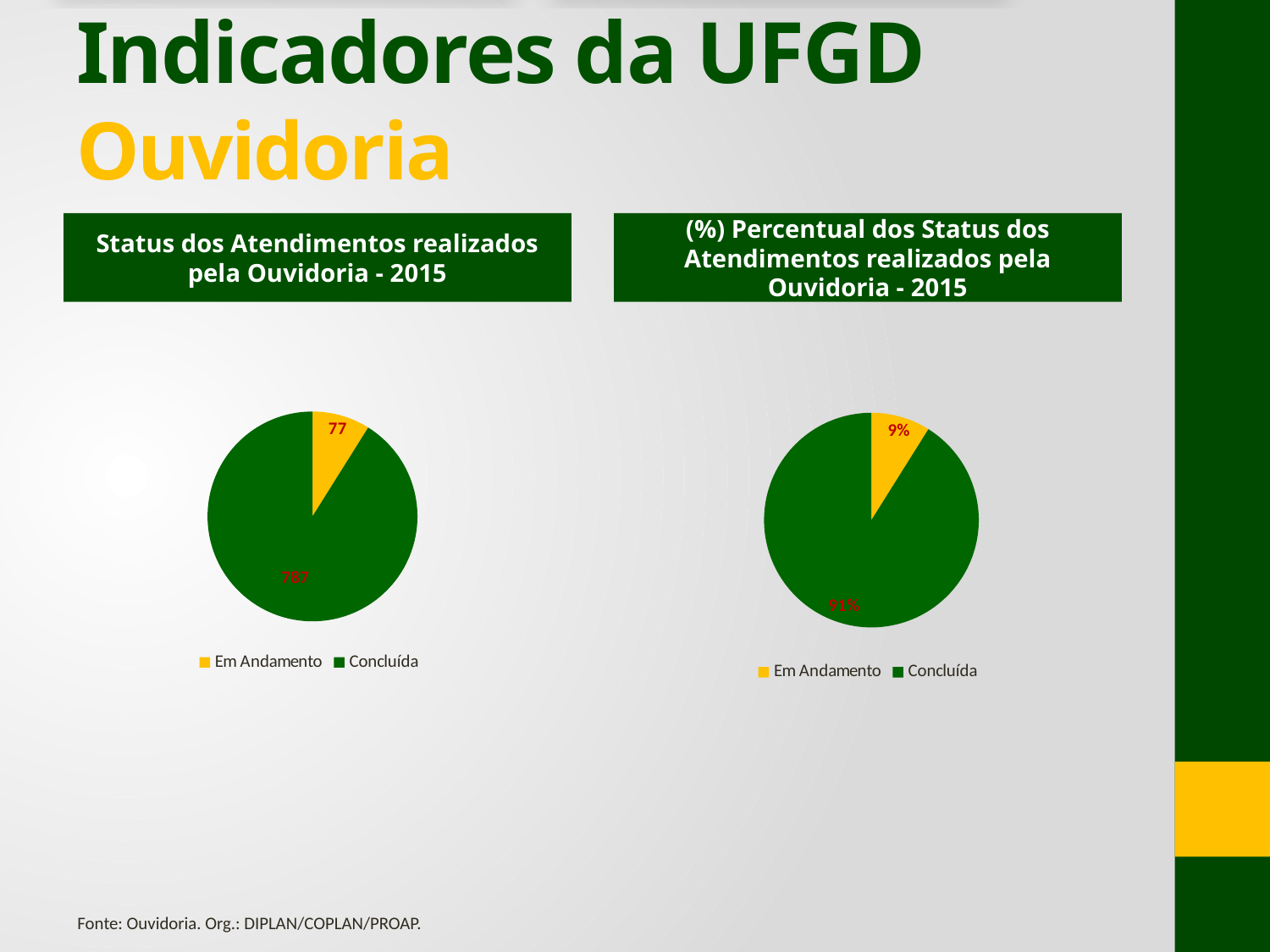
In the left chart (Status dos Atendimentos realizados pela Ouvidoria - 2015), what is the value for Em Andamento? 77 How many categories does the legend of the right chart ((%) Percentual dos Status dos Atendimentos) list? 2 In the left chart (Status dos Atendimentos realizados pela Ouvidoria - 2015), what is the total of the two slices? 864 In the left chart (Status dos Atendimentos realizados pela Ouvidoria - 2015), which is larger, Em Andamento or Concluída? Concluída In the left chart (Status dos Atendimentos realizados pela Ouvidoria - 2015), which category has the largest slice? Concluída In the left chart (Status dos Atendimentos realizados pela Ouvidoria - 2015), what is the value for Concluída? 787 What kind of chart is the left chart (Status dos Atendimentos realizados pela Ouvidoria - 2015)? Pie chart In the left chart (Status dos Atendimentos realizados pela Ouvidoria - 2015), what is the difference between Concluída and Em Andamento? 710 In the right chart ((%) Percentual dos Status dos Atendimentos), what percentage is shown for Concluída? 91% In the right chart ((%) Percentual dos Status dos Atendimentos), what colour is the Em Andamento slice? Yellow In the right chart ((%) Percentual dos Status dos Atendimentos), which category has the smallest slice? Em Andamento In the right chart ((%) Percentual dos Status dos Atendimentos), what percentage is shown for Em Andamento? 9%